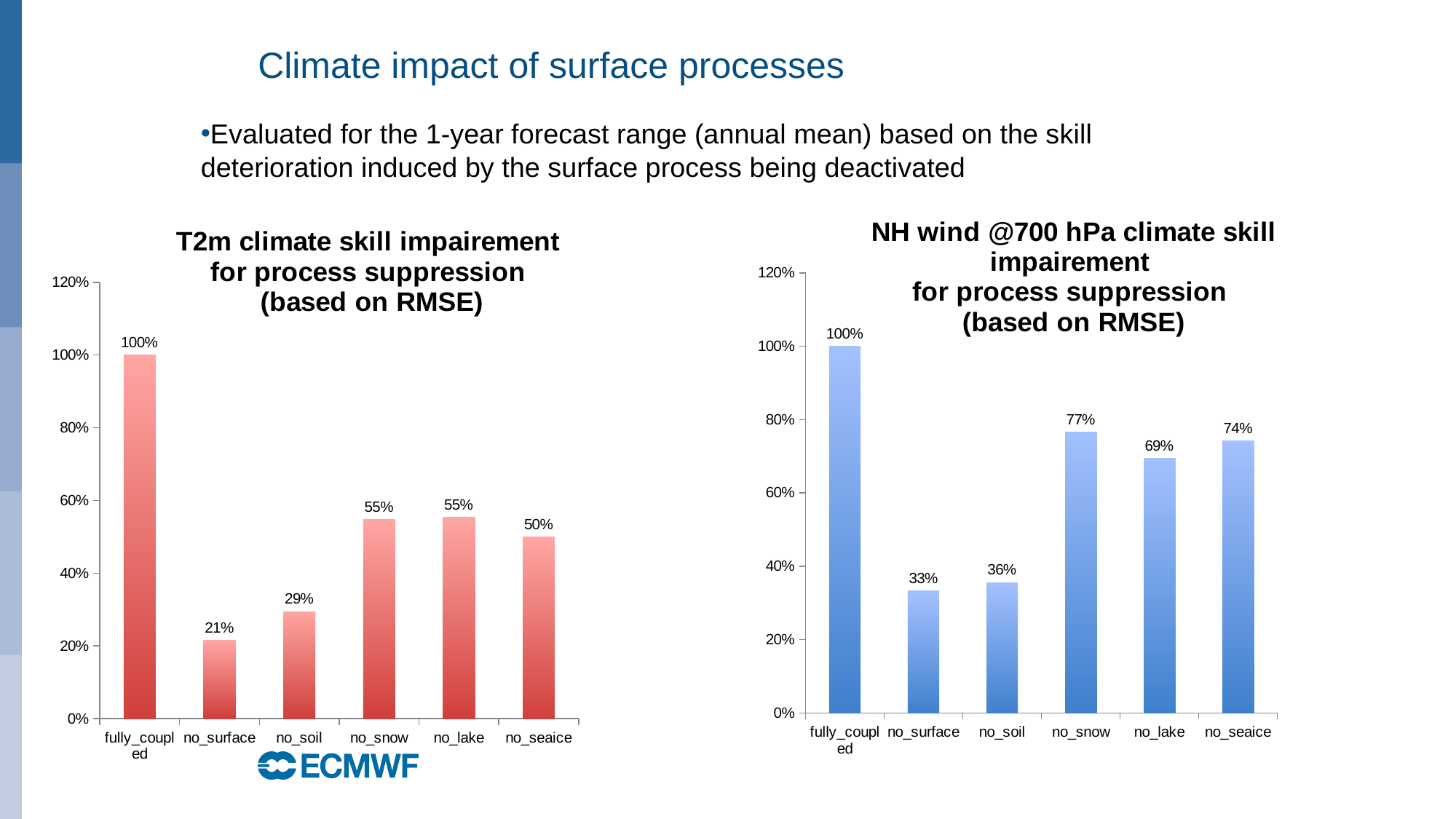
In the T2m climate skill impairement chart, what is the value for no_surface? 21% In the NH wind @700 hPa climate skill impairement chart, what is the value for no_snow? 77% What colour are the bars in the T2m climate skill impairement chart? red What kind of chart is the NH wind @700 hPa climate skill impairement chart? bar chart In the NH wind @700 hPa climate skill impairement chart, what is the value for no_soil? 36% In the T2m climate skill impairement chart, which is larger, the value for no_soil or the value for no_seaice? no_seaice How many categories are shown in the T2m climate skill impairement chart? 6 In the NH wind @700 hPa climate skill impairement chart, which is larger, the value for no_surface or the value for no_seaice? no_seaice In the NH wind @700 hPa climate skill impairement chart, which category has the highest value? fully_coupled In the T2m climate skill impairement chart, which category has the lowest value? no_surface In the NH wind @700 hPa climate skill impairement chart, what is the difference between the values for no_snow and no_lake? 8% In the T2m climate skill impairement chart, what is the difference between the values for no_soil and no_surface? 8%